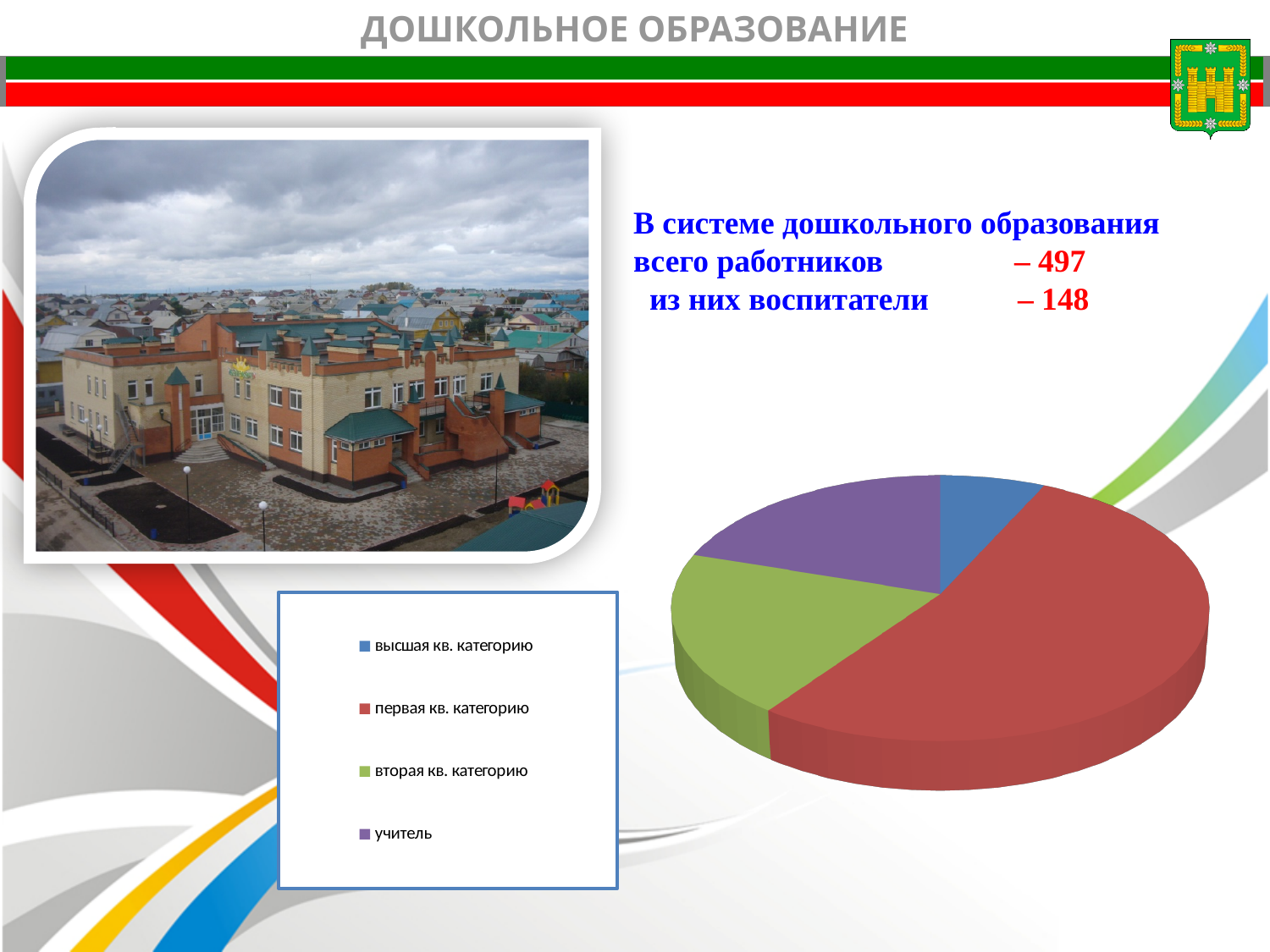
Which slice is larger: высшая кв. категорию or вторая кв. категорию? вторая кв. категорию Which colour represents первая кв. категорию in the pie chart? red How many entries does the legend of the pie chart list? 4 Which category is shown in purple in the pie chart? учитель Which category has the smallest slice in the pie chart? высшая кв. категорию What kind of chart is shown on the slide? pie chart Which slice is larger: первая кв. категорию or вторая кв. категорию? первая кв. категорию Which slice is larger: учитель or высшая кв. категорию? учитель How many slices does the pie chart have? 4 Which category has the largest slice in the pie chart? первая кв. категорию